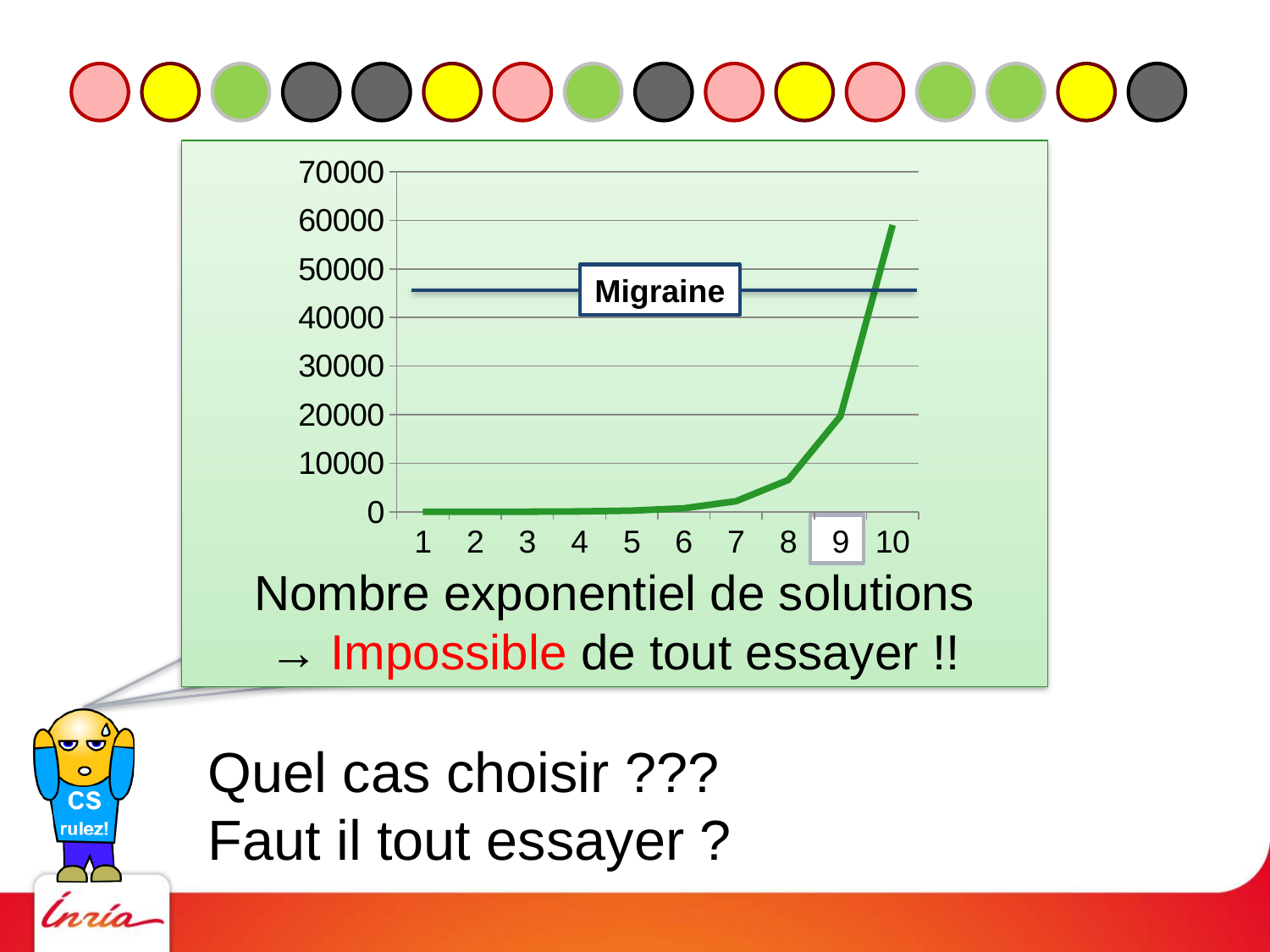
Is the value of the green line at x = 7 greater or less than 10000? less Is the value of the green line at x = 10 greater or less than 50000? greater At which x value does the green line reach its highest point? 10 Is the value of the green line at x = 8 greater or less than 10000? less What is the label shown on the horizontal line in the chart? Migraine What kind of chart is shown on the slide? line chart Which is larger: the value of the green line at x = 10 or at x = 9? x = 10 How many points are plotted along the x axis of the chart? 10 Do the values of the green line rise or fall as the x axis goes from 1 to 10? rise